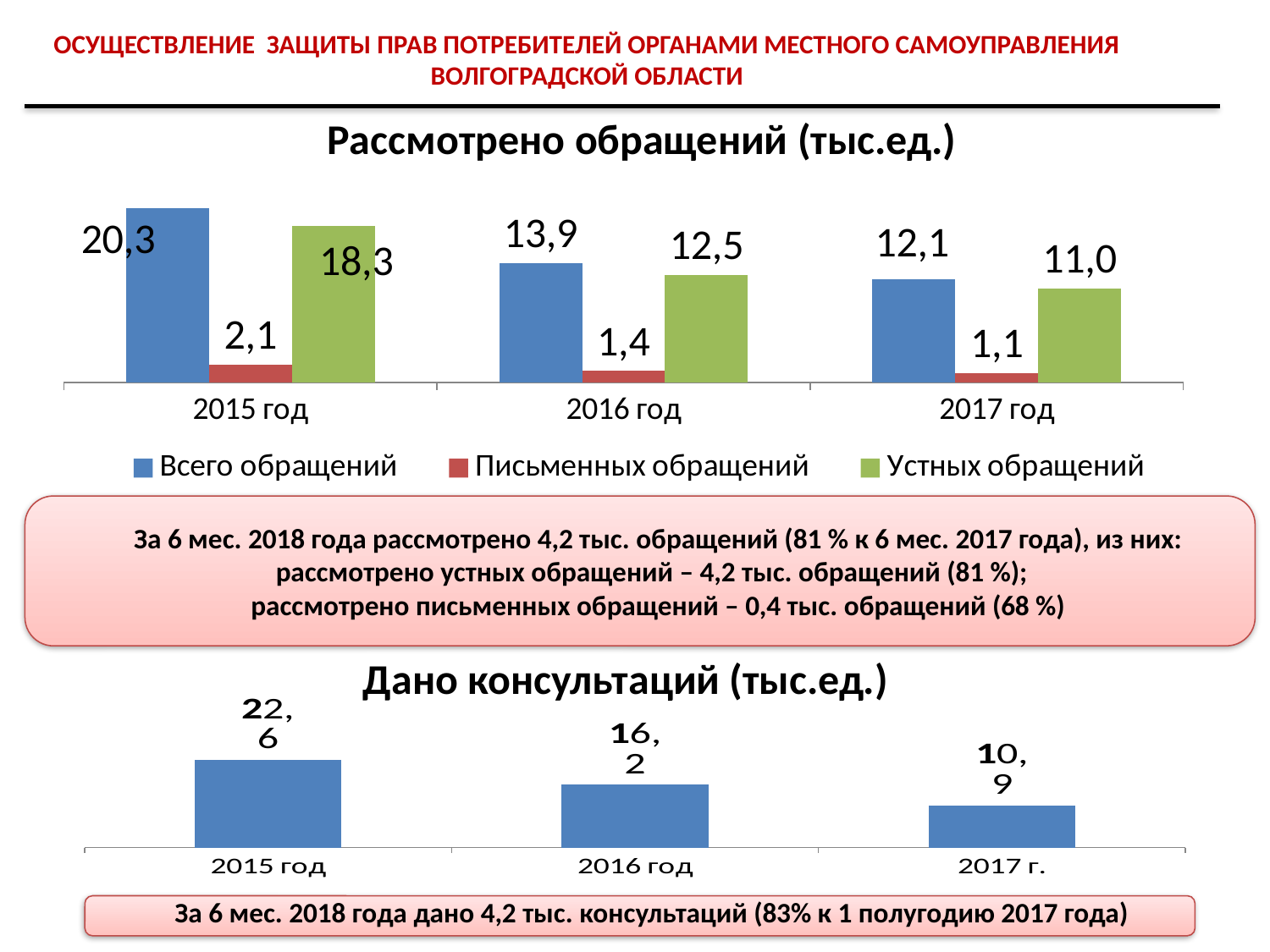
In the chart titled "Рассмотрено обращений (тыс.ед.)", what is the value for "Всего обращений" in 2015 год? 20,3 In the chart titled "Дано консультаций (тыс.ед.)", what is the difference between the values for 2015 год and 2017 г.? 11,7 In the chart titled "Дано консультаций (тыс.ед.)", which year has the lowest value? 2017 г. In the chart titled "Рассмотрено обращений (тыс.ед.)", which year has the highest value for "Всего обращений"? 2015 год In the chart titled "Рассмотрено обращений (тыс.ед.)", how many series does the legend list? 3 In the chart titled "Рассмотрено обращений (тыс.ед.)", what is the value for "Письменных обращений" in 2016 год? 1,4 In the chart titled "Рассмотрено обращений (тыс.ед.)", does the value for "Всего обращений" rise or fall from 2015 год to 2017 год? fall In the chart titled "Дано консультаций (тыс.ед.)", what is the value for 2016 год? 16,2 In the chart titled "Рассмотрено обращений (тыс.ед.)", which year has the lowest value for "Письменных обращений"? 2017 год In the chart titled "Рассмотрено обращений (тыс.ед.)", what is the value for "Устных обращений" in 2017 год? 11,0 What kind of chart is the chart titled "Дано консультаций (тыс.ед.)"? bar chart In the chart titled "Рассмотрено обращений (тыс.ед.)", what is the difference between "Всего обращений" in 2015 год and in 2016 год? 6,4